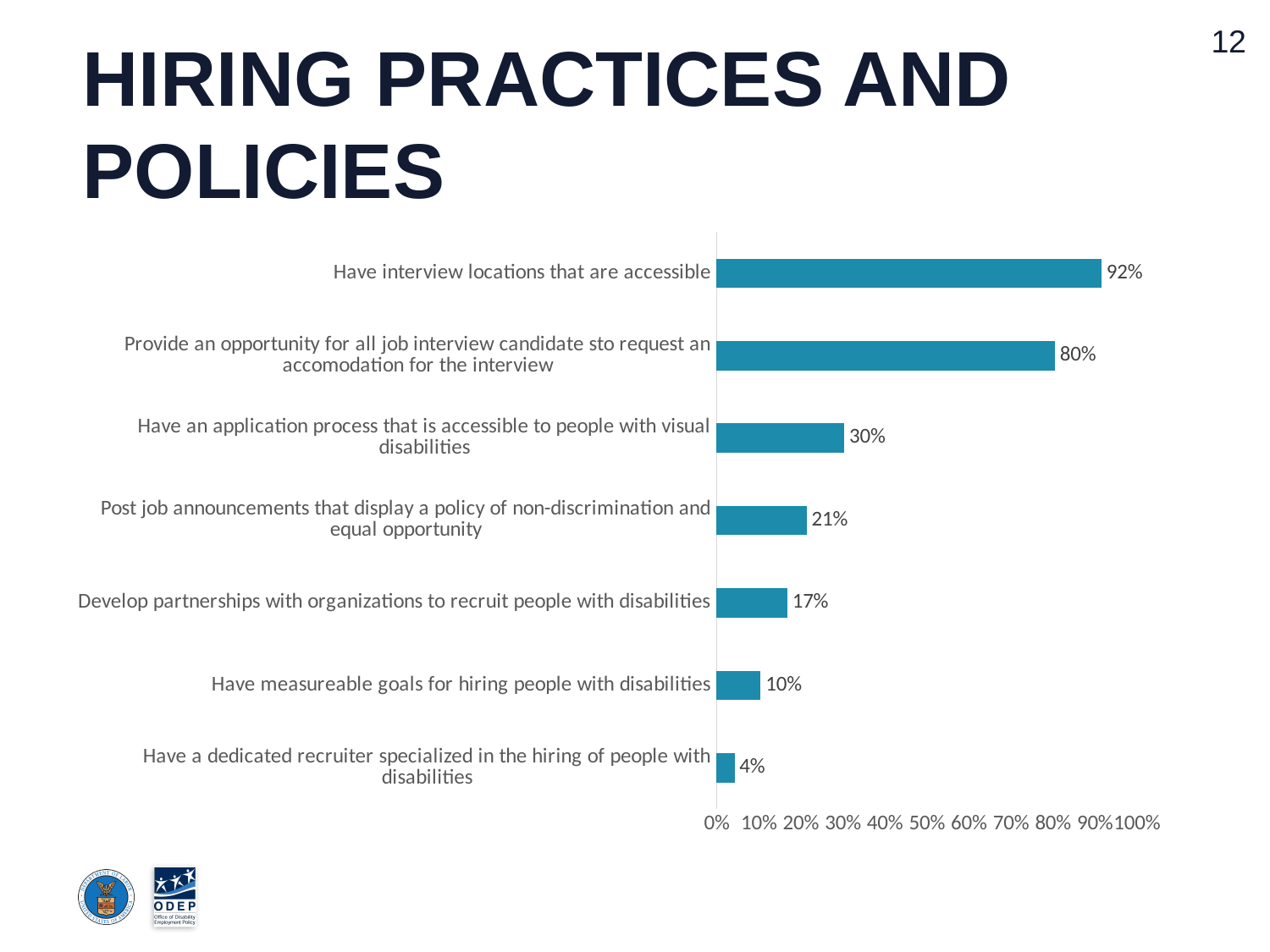
What percentage of respondents have interview locations that are accessible? 92% Which hiring practice has the highest percentage? Have interview locations that are accessible What percentage post job announcements that display a policy of non-discrimination and equal opportunity? 21% Is the value for 'Provide an opportunity for all job interview candidates to request an accommodation for the interview' greater or less than 70%? greater What is the value for 'Have measureable goals for hiring people with disabilities'? 10% Which is larger: the value for 'Have an application process that is accessible to people with visual disabilities' or the value for 'Develop partnerships with organizations to recruit people with disabilities'? Have an application process that is accessible to people with visual disabilities How many hiring practices are shown in the chart? 7 What is the difference between the values for 'Develop partnerships with organizations to recruit people with disabilities' and 'Have a dedicated recruiter specialized in the hiring of people with disabilities'? 13% What is the title of the slide containing the chart? Hiring Practices and Policies Which hiring practice has the lowest percentage? Have a dedicated recruiter specialized in the hiring of people with disabilities What is the difference between the percentage that have accessible interview locations and the percentage that provide an opportunity for all job interview candidates to request an accommodation? 12% What kind of chart is shown on the slide? Bar chart